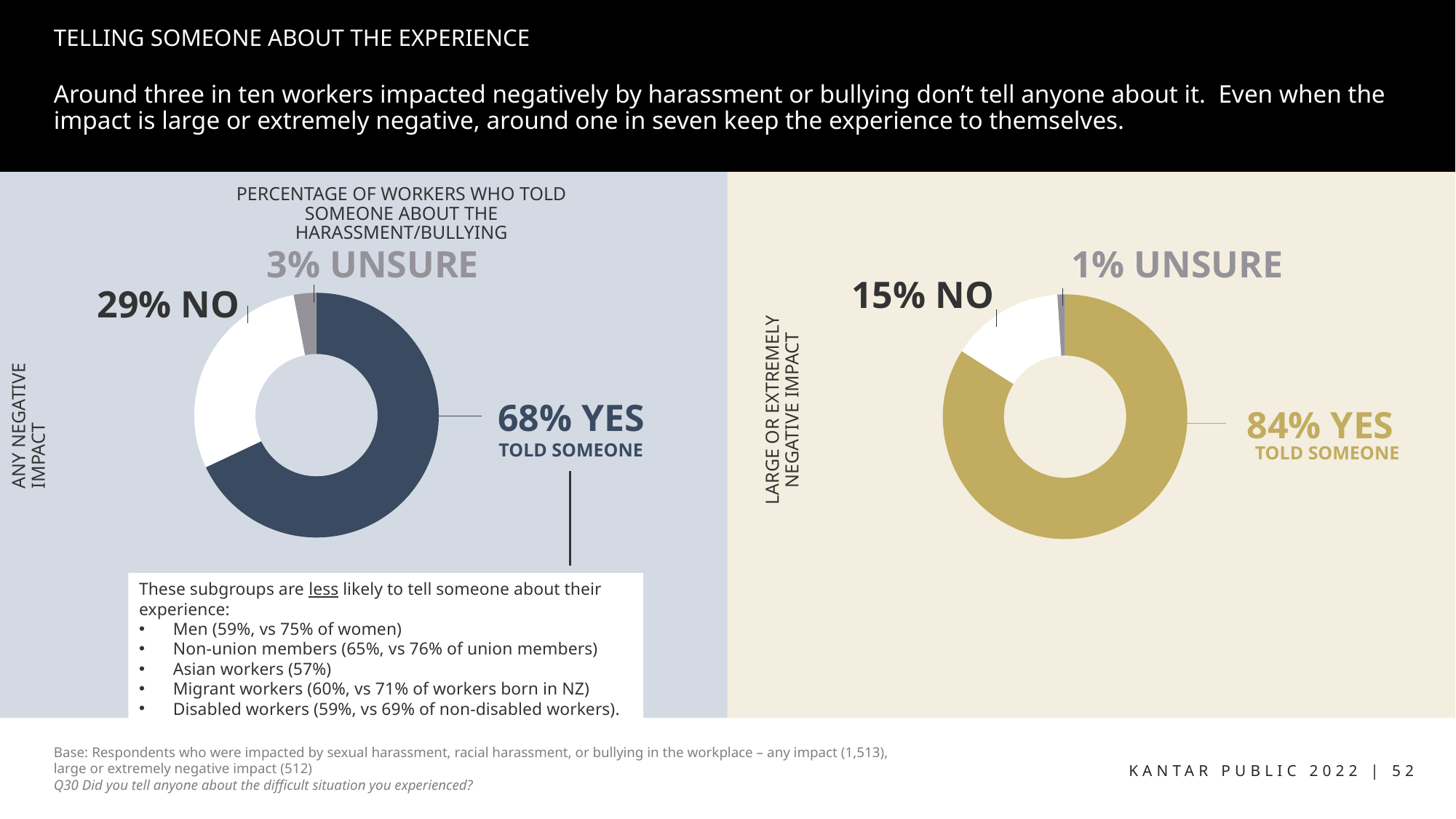
In the 'Large or extremely negative impact' donut chart on the right, what percentage of workers said yes, they told someone? 84% What is the difference between the 'Yes' percentage in the right-hand chart (large or extremely negative impact) and the 'Yes' percentage in the left-hand chart (any negative impact)? 16 percentage points Which chart shows a larger 'No' share: the 'Any negative impact' chart on the left or the 'Large or extremely negative impact' chart on the right? Any negative impact (left) How many response categories are shown in the 'Any negative impact' donut chart on the left? 3 In the 'Large or extremely negative impact' donut chart on the right, what percentage of workers said no? 15% In the 'Large or extremely negative impact' donut chart on the right, what percentage of workers were unsure? 1% In the 'Any negative impact' donut chart on the left, what percentage of workers said no? 29% In the 'Any negative impact' donut chart on the left, what percentage of workers were unsure? 3% What type of chart is used on this slide to show the percentage of workers who told someone? Donut (pie) chart In the 'Any negative impact' donut chart on the left, which response has the largest share? Yes (told someone) In the 'Large or extremely negative impact' donut chart on the right, which response has the smallest share? Unsure In the 'Any negative impact' donut chart on the left, what percentage of workers said yes, they told someone? 68%